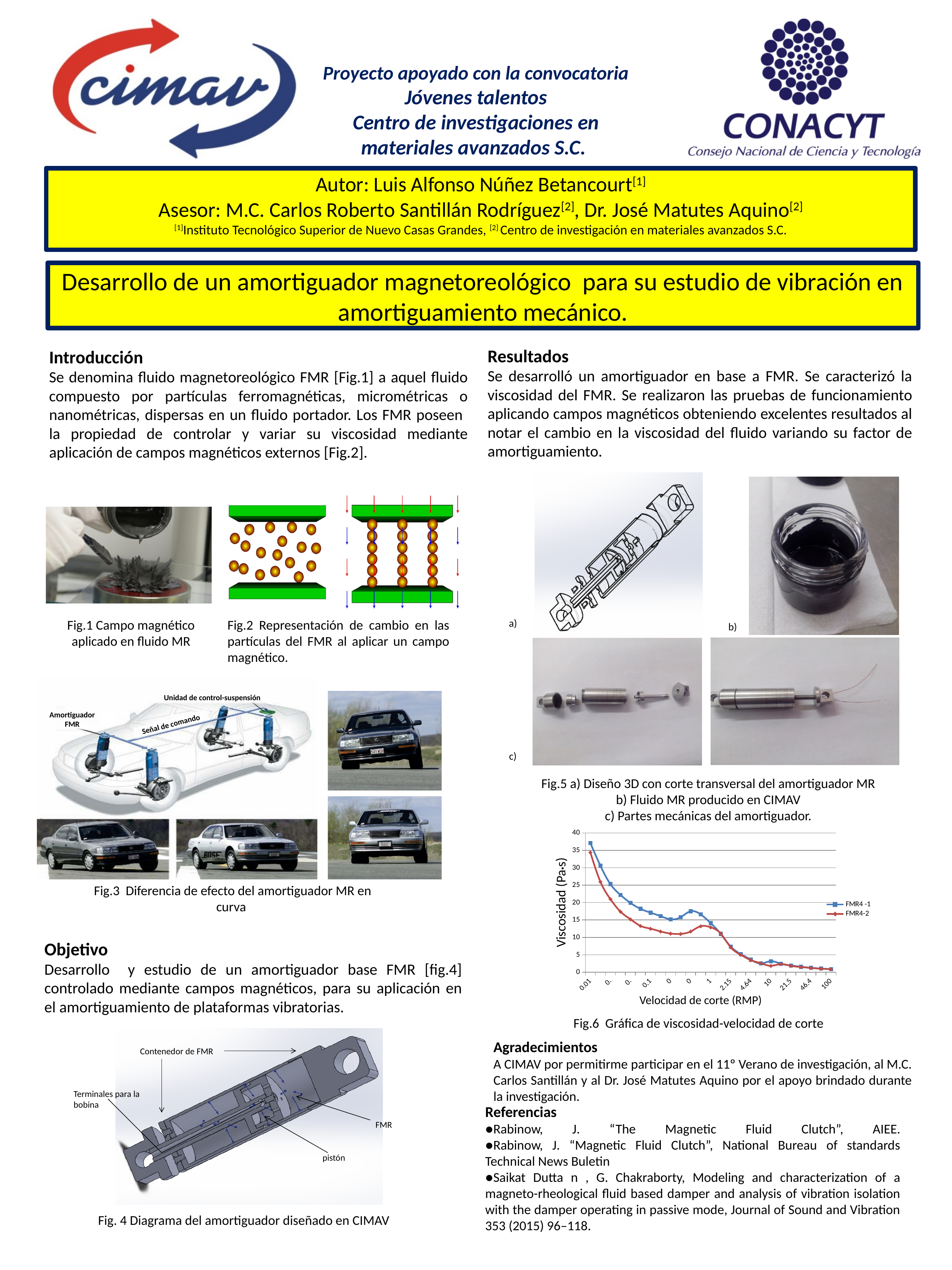
What are the two series named in the legend of the Fig.6 chart? FMR4 -1 and FMR4-2 In the Fig.6 chart, do the viscosity values generally rise or fall as the shear rate (Velocidad de corte) increases along the x axis? fall In the Fig.6 chart, which series has the higher viscosity at the first x-axis point (0.01)? FMR4 -1 In the Fig.6 chart, which series is plotted in red? FMR4-2 What kind of chart is Fig.6 (Gráfica de viscosidad-velocidad de corte)? line chart How many series does the legend of the Fig.6 chart list? 2 In the Fig.6 chart, at which x-axis value does the FMR4 -1 series reach its highest viscosity? 0.01 In the Fig.6 chart, is the viscosity of FMR4 -1 at the x-axis value 0.01 greater or less than 30? greater In the Fig.6 chart, is the viscosity of FMR4-2 at the x-axis value 100 greater or less than 5? less In the Fig.6 chart, is the viscosity of FMR4 -1 at the x-axis value 1 greater or less than 10? greater What is the y-axis title of the Fig.6 chart? Viscosidad (Pa·s) In the Fig.6 chart, which series has the higher viscosity at the x-axis value 0.1? FMR4 -1